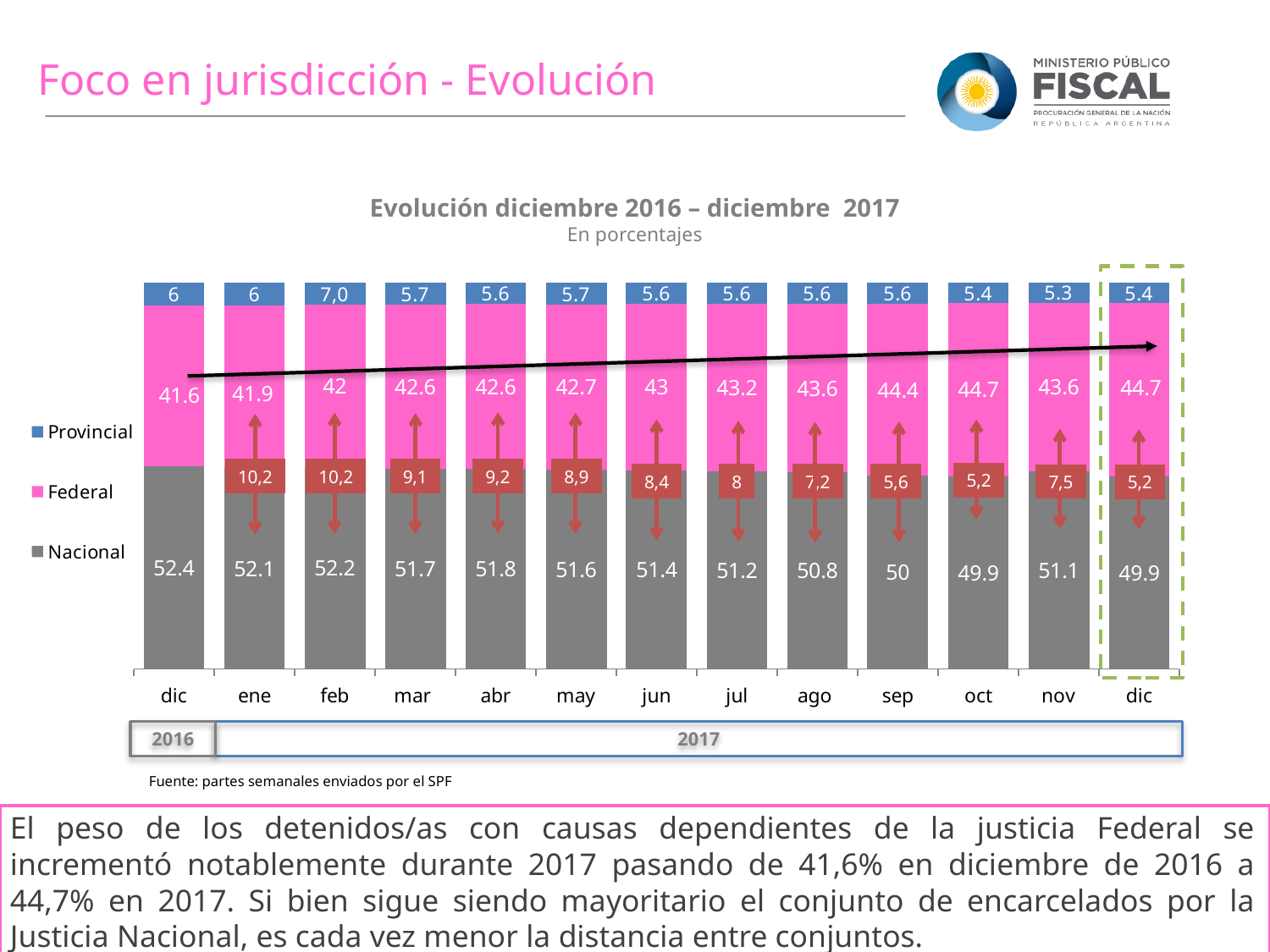
In which month is the Nacional value highest? dic 2016 What is the Nacional value for sep 2017? 50 In which month is the Provincial value lowest? nov What is the difference between the Nacional and Federal values in dic 2017? 5.2 How many series does the legend list? 3 What kind of chart is shown? stacked bar chart Which is larger, the Federal value for oct or for nov? oct How many months are shown on the x axis? 13 What is the total of the stacked bar for dic 2016? 100 Does the Federal value rise or fall from dic 2016 to dic 2017? rise What is the Provincial value for feb 2017? 7,0 What is the Federal value for dic 2016? 41.6